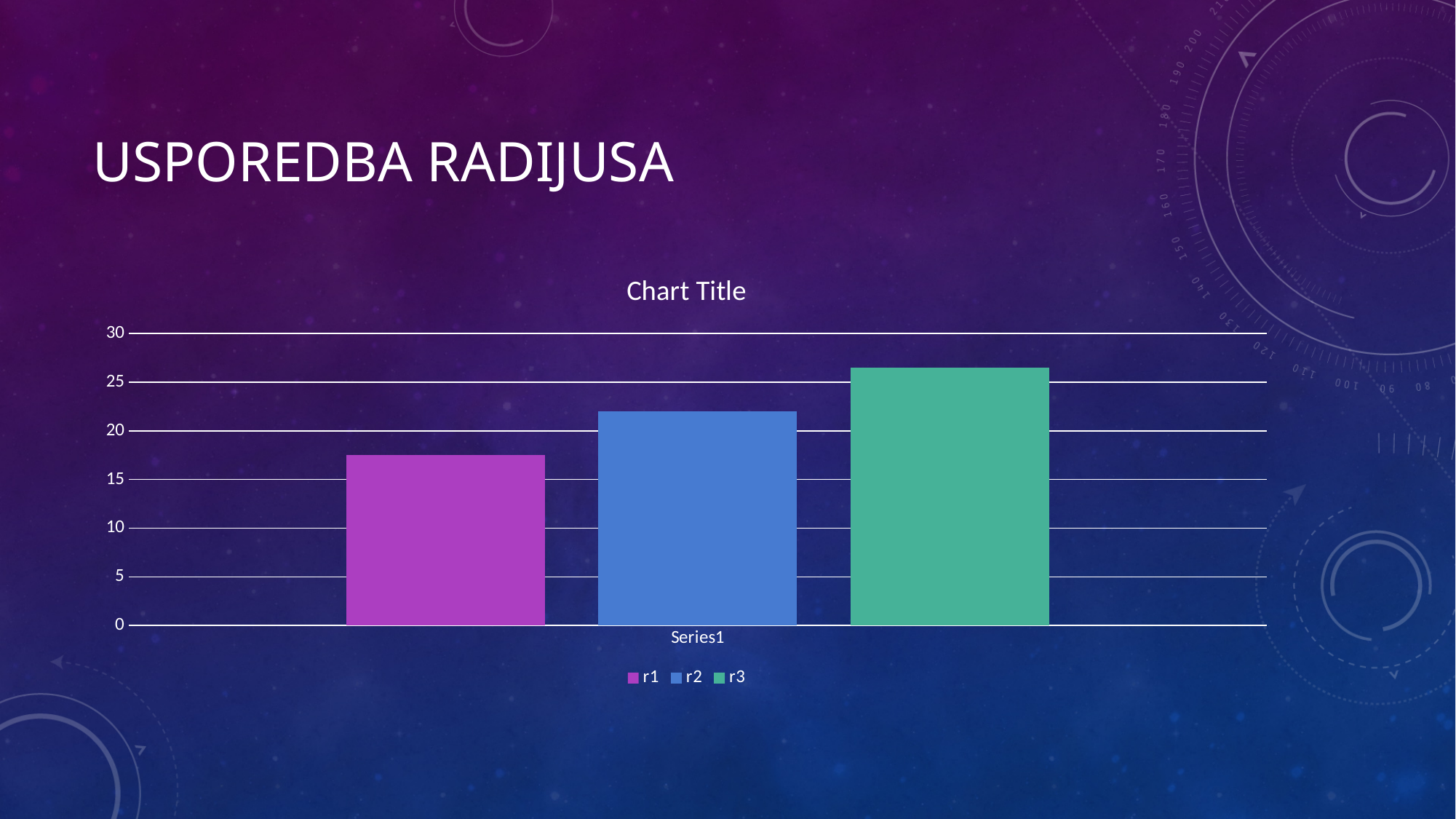
What kind of chart is shown on the slide? bar chart Which series has the shortest bar? r1 Is the value for r3 greater or less than 25? greater How many series does the legend list? 3 Is the value for r1 greater or less than 20? less Which is larger, the value for r1 or the value for r2? r2 What is the category label shown on the x axis? Series1 Is the value for r2 greater or less than 20? greater Which is larger, the value for r2 or the value for r3? r3 What is the title shown above the chart? Chart Title Which series has the tallest bar? r3